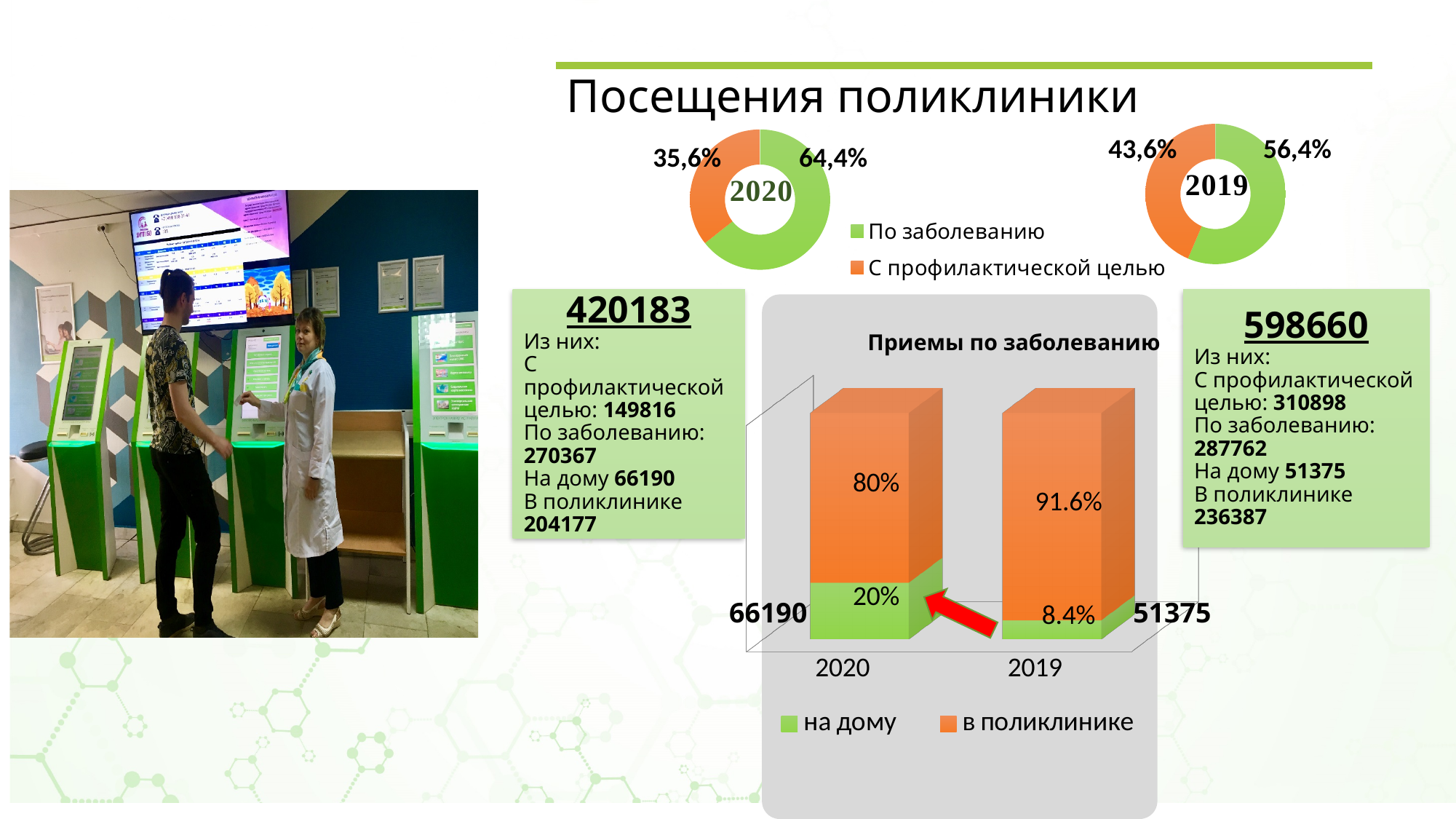
In the 2020 donut chart, what share of visits is labelled 'По заболеванию'? 64,4% In the chart 'Приемы по заболеванию', what is the value for 'на дому' in 2019? 8.4% In the 2019 donut chart, what share of visits is labelled 'По заболеванию'? 56,4% What kind of chart is 'Приемы по заболеванию'? Stacked bar chart In the 2019 donut chart, which category has the larger share: 'По заболеванию' or 'С профилактической целью'? По заболеванию In the chart 'Приемы по заболеванию', what is the value for 'на дому' in 2020? 20% In the chart 'Приемы по заболеванию', what is the value for 'в поликлинике' in 2019? 91.6% How many series does the legend of the donut charts list? 2 In the 2020 donut chart, what share of visits is labelled 'С профилактической целью'? 35,6% How many categories are shown on the x axis of the chart 'Приемы по заболеванию'? 2 In the chart 'Приемы по заболеванию', what is the difference between the 'в поликлинике' values for 2019 and 2020? 11.6%